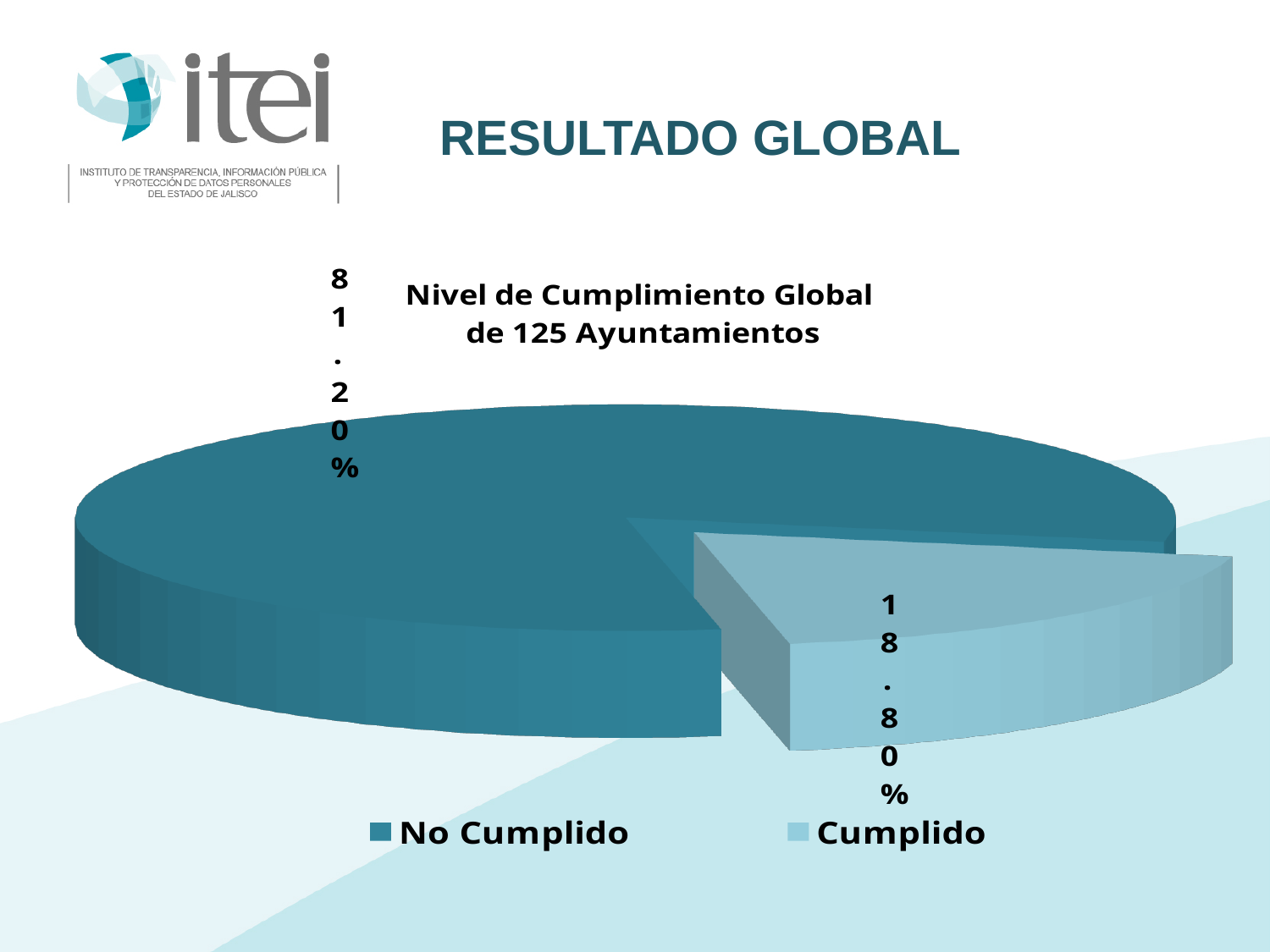
What are the two legend entries of the chart? No Cumplido and Cumplido How many entries does the legend list? 2 How many Ayuntamientos does the chart title say are covered? 125 What percentage of the pie is labelled for Cumplido? 18.80% Which is larger, the share for No Cumplido or the share for Cumplido? No Cumplido Which category has the smallest share of the pie? Cumplido How many slices does the pie chart have? 2 Which category has the largest share of the pie? No Cumplido What type of chart is shown on the slide? Pie chart What percentage of the pie is labelled for No Cumplido? 81.20% What is the difference in percentage points between the No Cumplido and Cumplido slices? 62.40 What is the title of the chart? Nivel de Cumplimiento Global de 125 Ayuntamientos